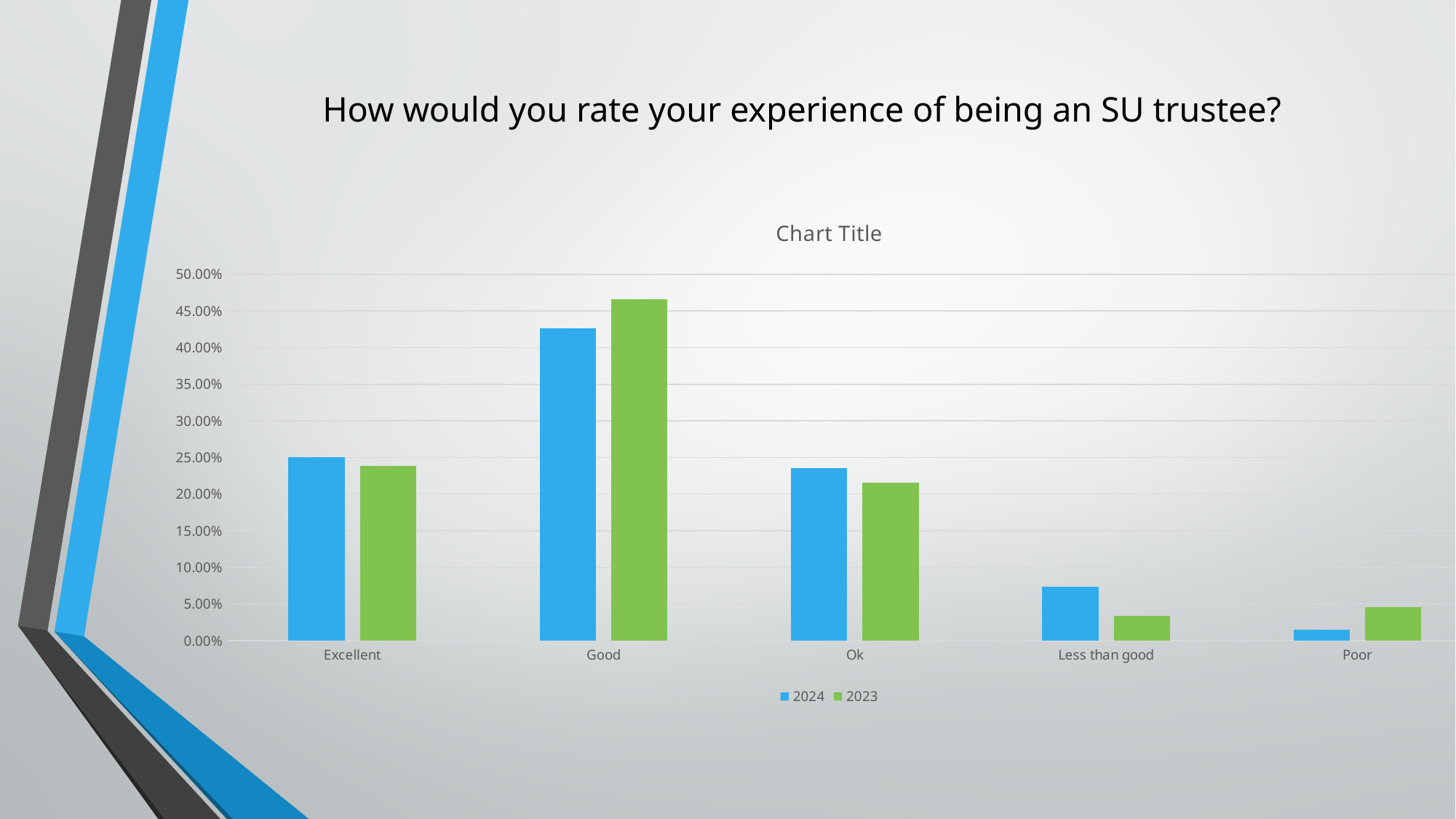
What kind of chart is shown on the slide? bar chart Which category has the lowest value for the 2024 series? Poor Which category has the highest value for the 2024 series? Good Which colour represents the 2023 series in the legend? green Is the 2023 value for Good greater or less than 45.00%? greater For the Less than good category, which series has the larger value, 2024 or 2023? 2024 For the Poor category, which series has the larger value, 2024 or 2023? 2023 For the Good category, which series has the larger value, 2024 or 2023? 2023 Which category has the highest value for the 2023 series? Good Is the 2024 value for Less than good greater or less than 5.00%? greater How many series does the legend list? 2 How many rating categories are shown on the x axis? 5